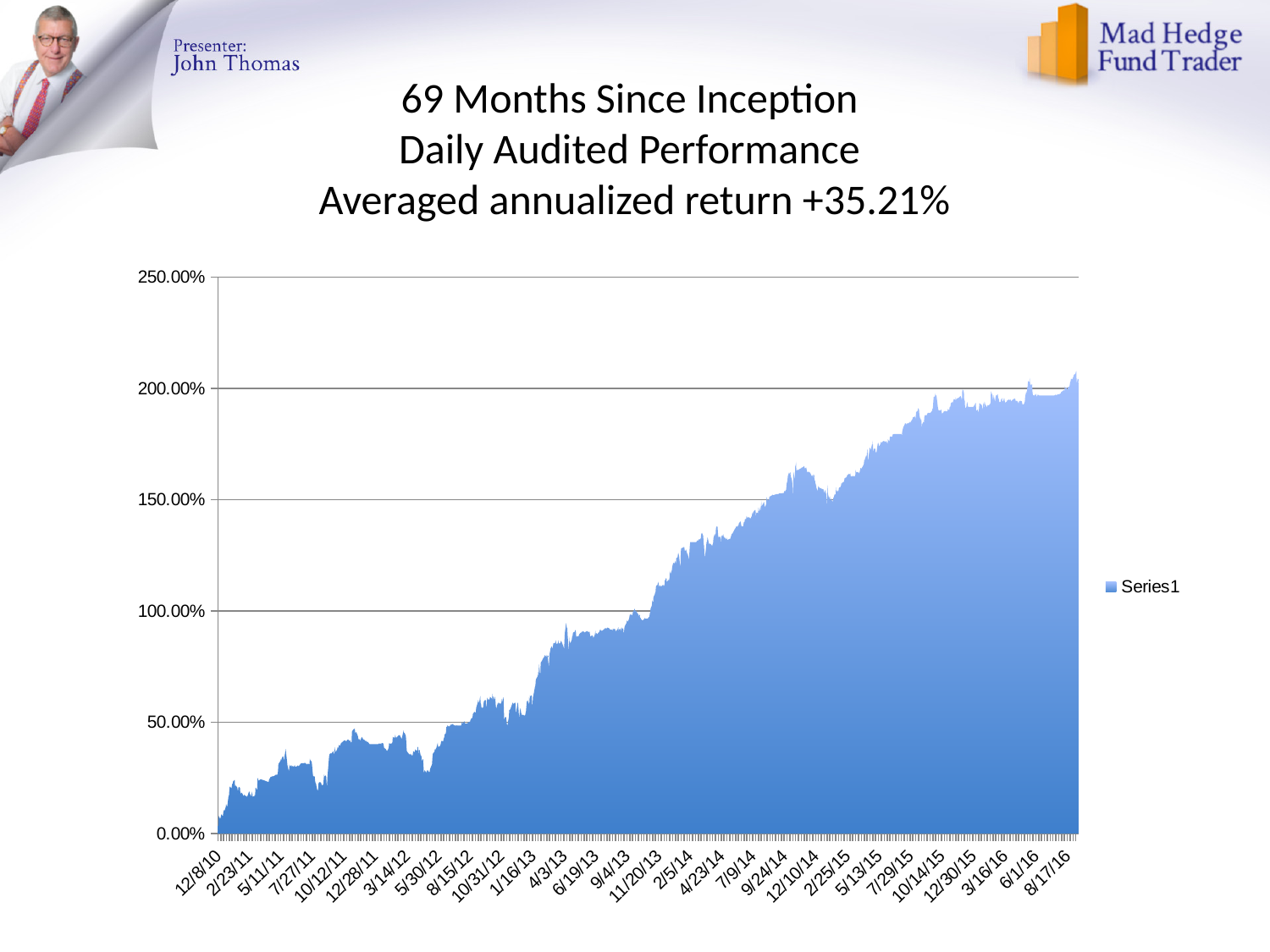
Is the value at 12/28/11 greater or less than 50.00%? less What is the name of the series shown in the legend? Series1 What averaged annualized return is stated in the chart title? +35.21% Is the value at 4/3/13 greater or less than 100.00%? less Is the value at 3/16/16 greater or less than 150.00%? greater What kind of chart is shown on the slide? area chart How many series does the legend list? 1 Do the values generally rise or fall from 12/8/10 to 8/17/16? rise